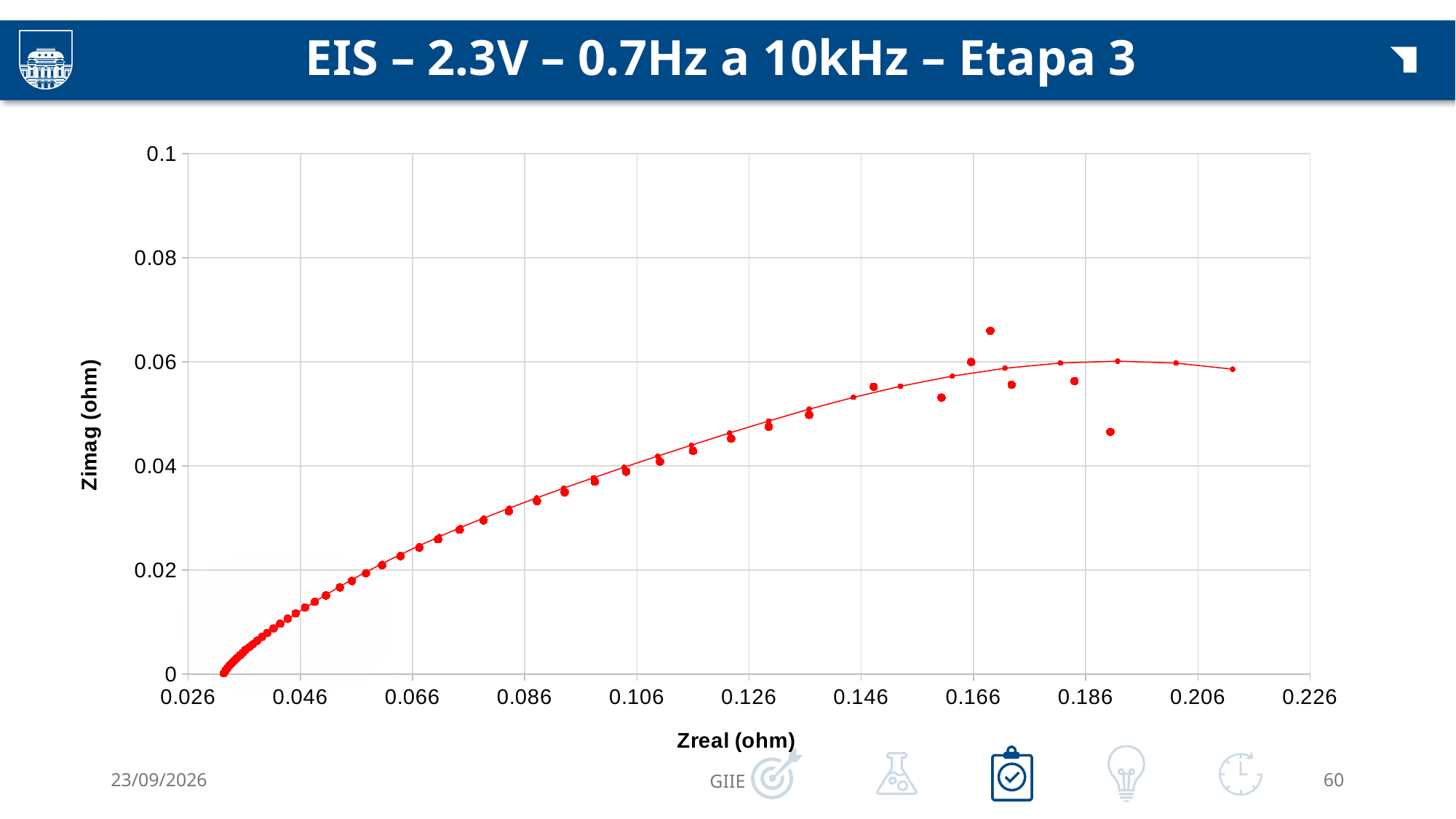
Is the Zimag value of the point at Zreal 0.146 greater or less than 0.06? less Is the Zimag value of the point at Zreal 0.126 greater or less than 0.04? greater Is the Zimag value of the point at Zreal 0.066 greater or less than 0.02? greater Which has the larger Zimag value: the point at Zreal 0.086 or the point at Zreal 0.126? the point at Zreal 0.126 What is the title of the chart on the slide? EIS – 2.3V – 0.7Hz a 10kHz – Etapa 3 What is the label of the horizontal axis of the chart? Zreal (ohm) Do the Zimag values generally rise or fall as Zreal increases from 0.026 to about 0.186? rise What is the maximum value shown on the vertical axis of the chart? 0.1 What kind of chart is shown on the slide? scatter chart